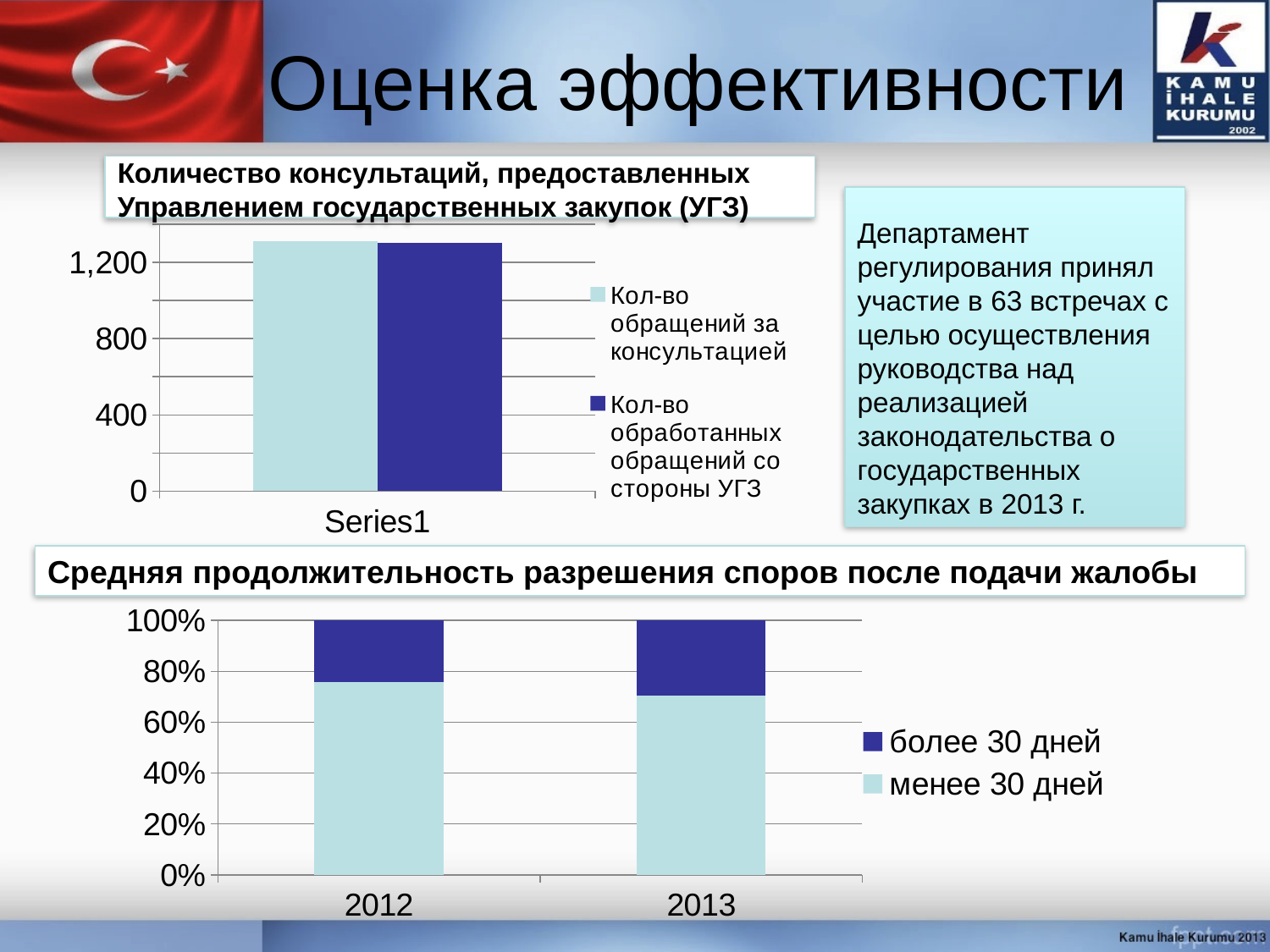
In the bottom chart, does the share of "менее 30 дней" rise or fall from 2012 to 2013? fall In the bottom chart, is the share of "менее 30 дней" for 2013 greater or less than 80%? less What is the category label shown on the x axis of the top chart? Series1 In the bottom chart, is the share of "менее 30 дней" for 2012 greater or less than 60%? greater In the top chart, is the value for "Кол-во обработанных обращений со стороны УГЗ" greater or less than 800? greater How many categories are shown on the x axis of the bottom chart? 2 What kind of chart is the top chart titled "Количество консультаций, предоставленных Управлением государственных закупок (УГЗ)"? bar chart How many series does the legend of the top chart list? 2 How many series does the legend of the bottom chart list? 2 In the bottom chart, which year has the larger share of "более 30 дней", 2012 or 2013? 2013 What kind of chart is the bottom chart titled "Средняя продолжительность разрешения споров после подачи жалобы"? stacked bar chart